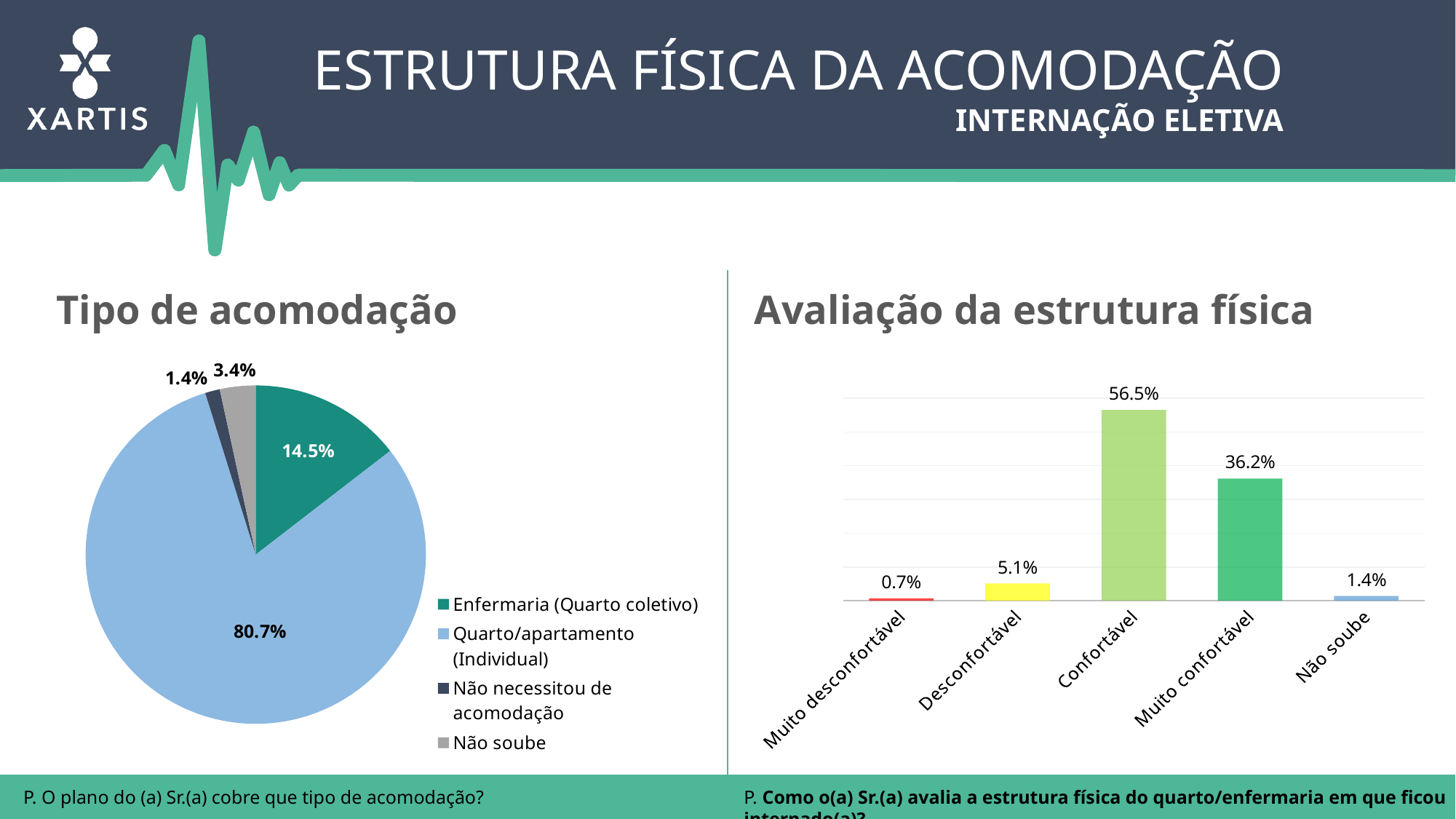
What kind of chart is 'Tipo de acomodação'? Pie chart In the 'Tipo de acomodação' pie chart, what is the value for 'Enfermaria (Quarto coletivo)'? 14.5% In the 'Tipo de acomodação' pie chart, which category has the smallest slice? Não necessitou de acomodação In the 'Avaliação da estrutura física' chart, which category has the highest value? Confortável In the 'Tipo de acomodação' pie chart, what share does 'Quarto/apartamento (Individual)' have? 80.7% In the 'Tipo de acomodação' pie chart, what is the difference between 'Quarto/apartamento (Individual)' and 'Enfermaria (Quarto coletivo)'? 66.2% What kind of chart is 'Avaliação da estrutura física'? Bar chart In the 'Avaliação da estrutura física' chart, what is the difference between 'Confortável' and 'Muito confortável'? 20.3% In the 'Tipo de acomodação' pie chart, how many categories does the legend list? 4 In the 'Avaliação da estrutura física' chart, what is the value for 'Confortável'? 56.5% In the 'Avaliação da estrutura física' chart, which category has the lowest value? Muito desconfortável In the 'Avaliação da estrutura física' chart, which is larger: 'Desconfortável' or 'Não soube'? Desconfortável